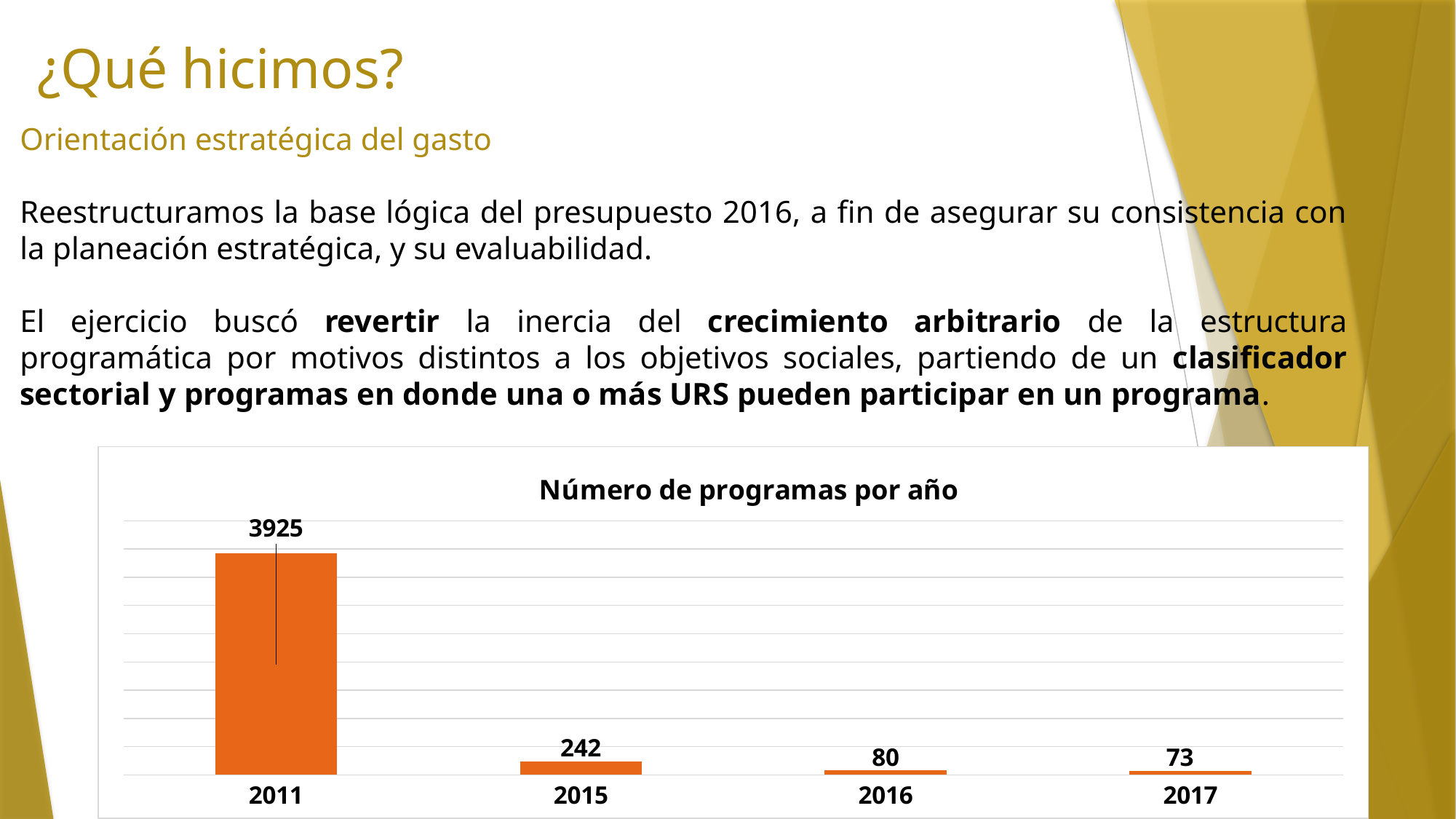
What is the value for 2016 in the chart? 80 Which is larger, the value for 2015 or the value for 2016? 2015 What is the value for 2015 in the chart? 242 Which year has the highest number of programs? 2011 What is the title of the chart? Número de programas por año How many years are shown on the x axis of the chart? 4 Which year has the lowest number of programs? 2017 What is the value for 2011 in the chart? 3925 What is the difference between the values for 2016 and 2017? 7 What is the value for 2017 in the chart? 73 What is the difference between the values for 2011 and 2015? 3683 What kind of chart is shown on the slide? bar chart